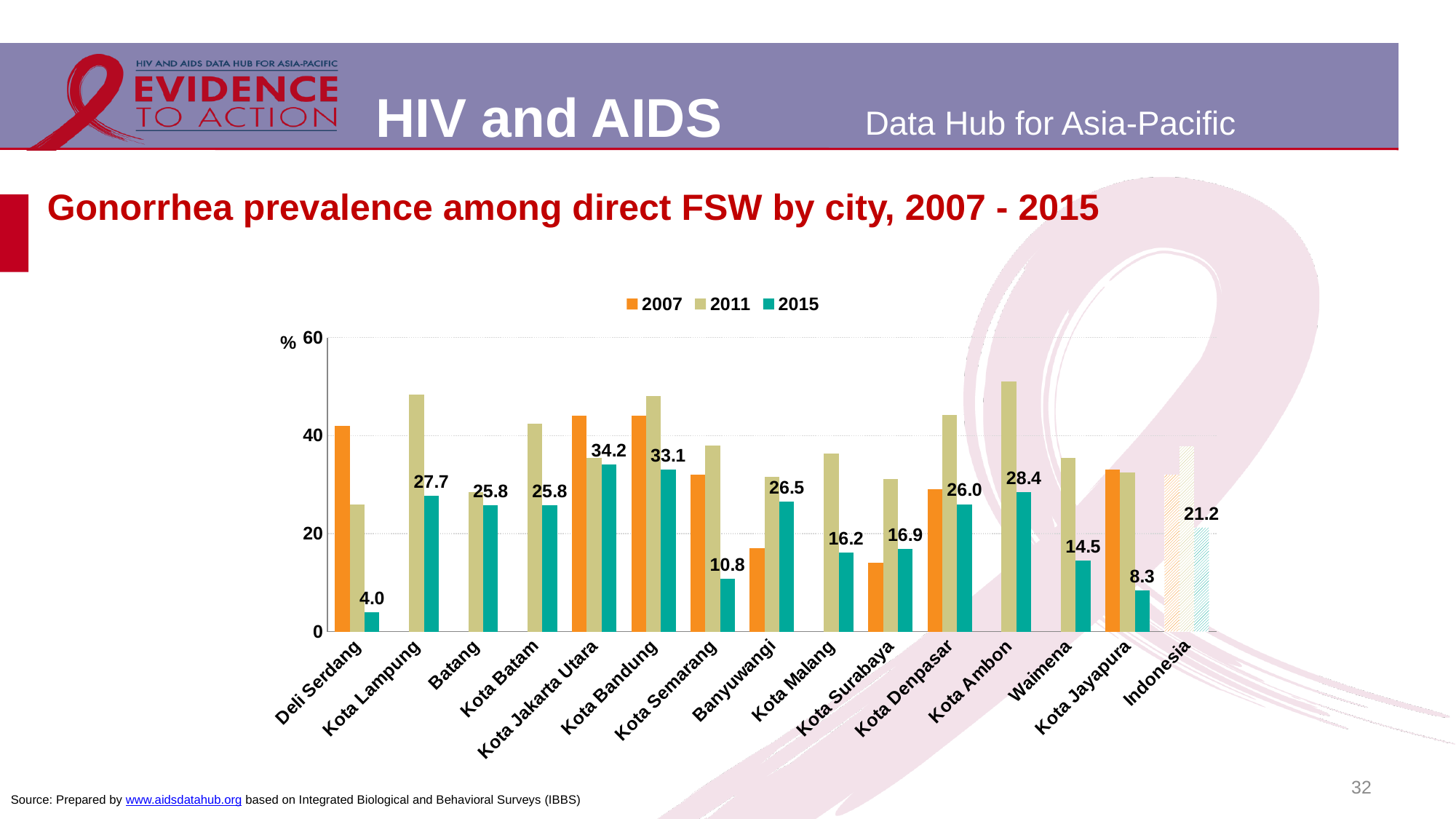
Which has the larger 2015 value, Kota Lampung or Batang? Kota Lampung What is the title of the chart? Gonorrhea prevalence among direct FSW by city, 2007 - 2015 Is the 2011 value for Kota Ambon greater or less than 40? greater What type of chart is shown on the slide? Bar chart What is the 2015 value for Deli Serdang? 4.0 What is the 2015 value for Indonesia? 21.2 What is the 2015 gonorrhea prevalence for Kota Jakarta Utara? 34.2 How many series does the legend list? 3 Which city has the lowest 2015 value? Deli Serdang Which city has the highest 2015 value? Kota Jakarta Utara What is the difference between the 2015 values for Kota Ambon and Waimena? 13.9 How many cities/categories are shown on the x axis? 15